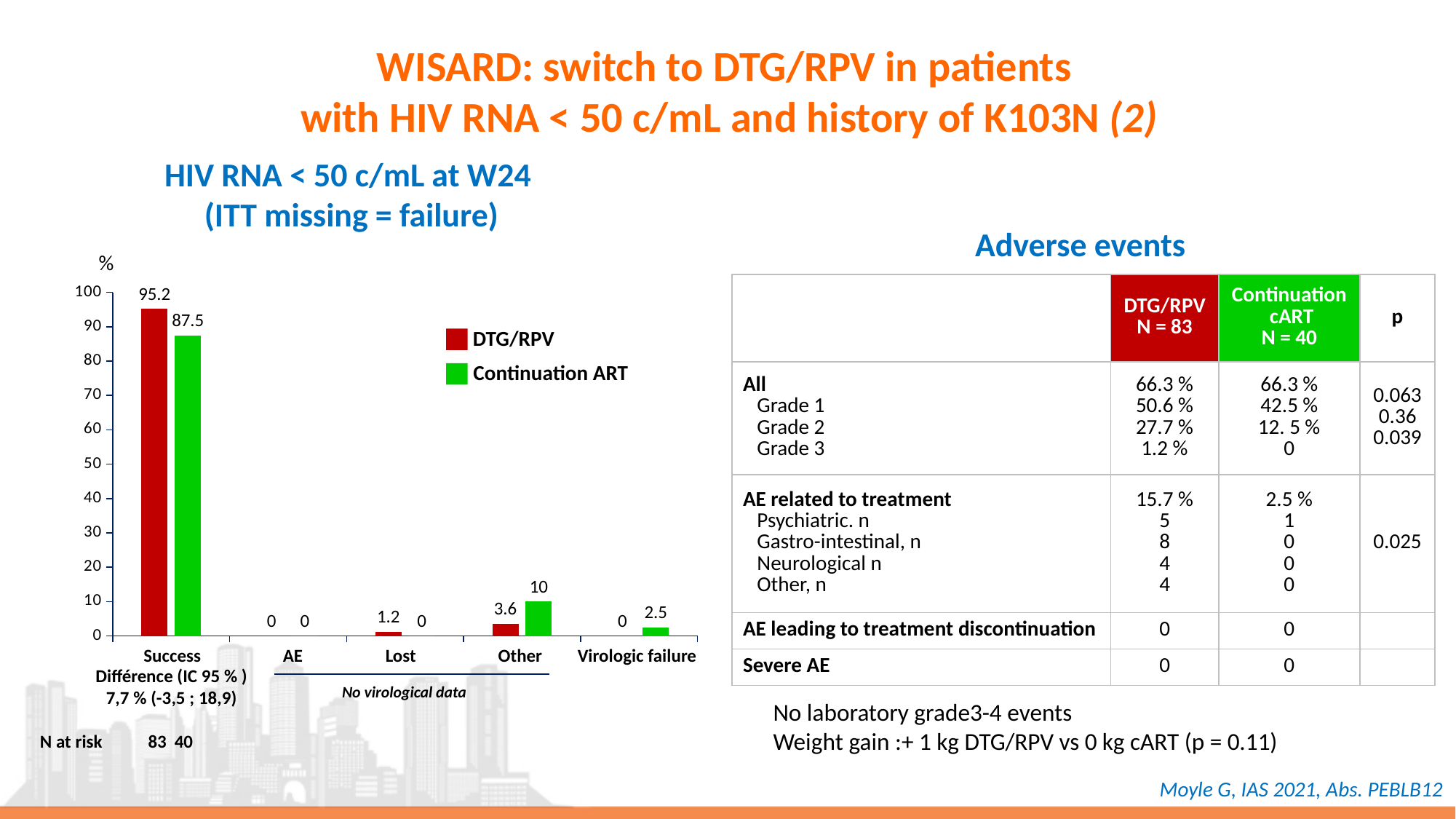
Which category has the highest value for DTG/RPV? Success How many series does the chart legend list? 2 What is the Virologic failure value for Continuation ART? 2.5 What is the Success value for DTG/RPV in the bar chart? 95.2 What is the value for DTG/RPV in the Lost category? 1.2 How many categories are shown on the x axis of the bar chart? 5 What is the value for Continuation ART in the Other category? 10 Which colour represents DTG/RPV in the bar chart? Red What kind of chart is shown on the slide? Bar chart What is the Success value for Continuation ART in the bar chart? 87.5 In the Other category, which series has the larger value, DTG/RPV or Continuation ART? Continuation ART What is the difference between the DTG/RPV and Continuation ART Success values? 7.7